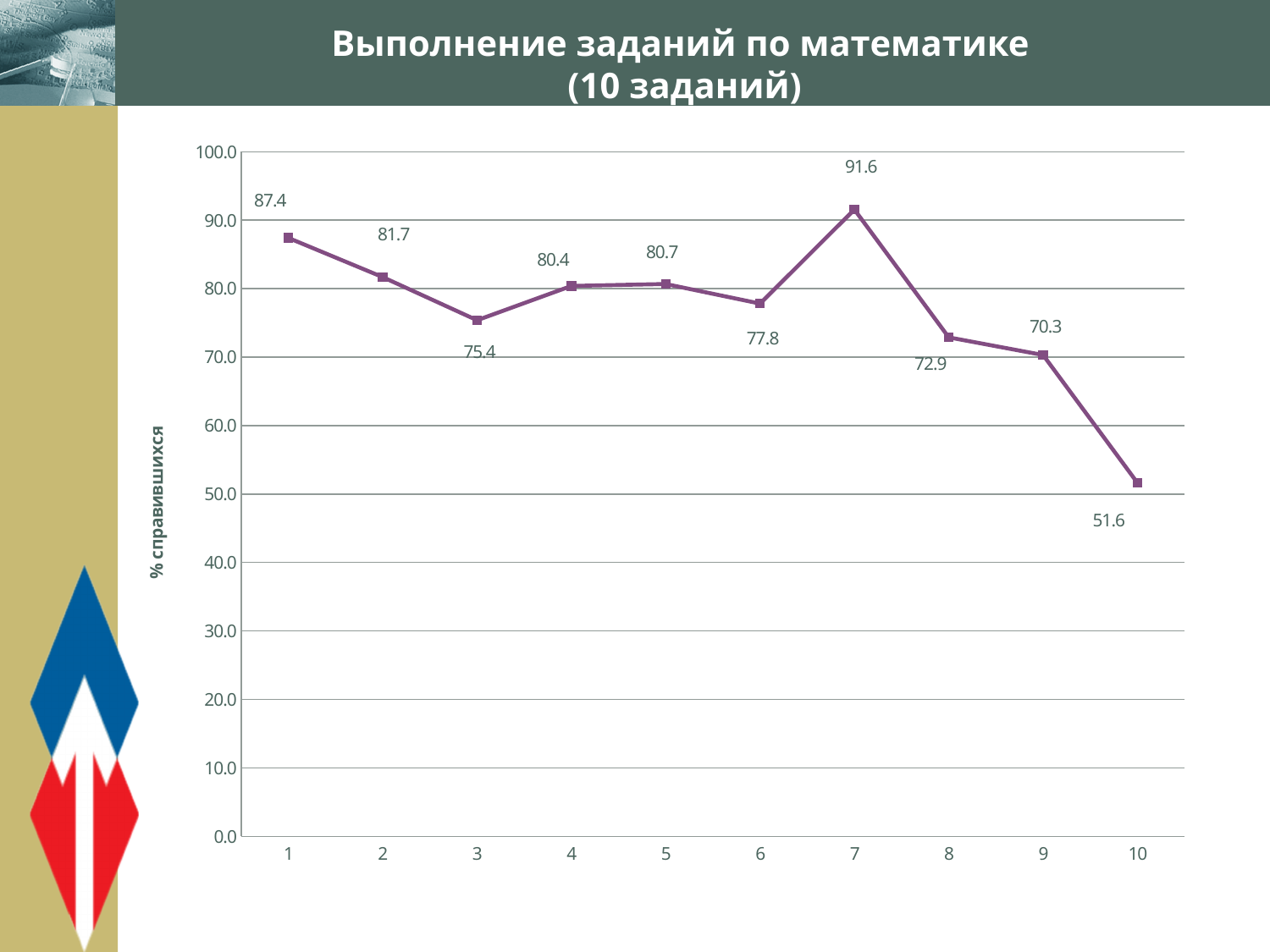
What is the value for task 3? 75.4 Do the values rise or fall from task 7 to task 10? Fall How many tasks are plotted on the x axis? 10 What is the difference between the values for task 1 and task 10? 35.8 Which task has the lowest percentage of students who completed it? 10 What is the label of the vertical axis? % справившихся What is the value for task 7? 91.6 What is the value for task 10? 51.6 Which task has the highest percentage of students who completed it? 7 What kind of chart is shown on the slide? Line chart Which is larger, the value for task 2 or the value for task 6? Task 2 Is the value for task 8 greater or less than 70.0? greater